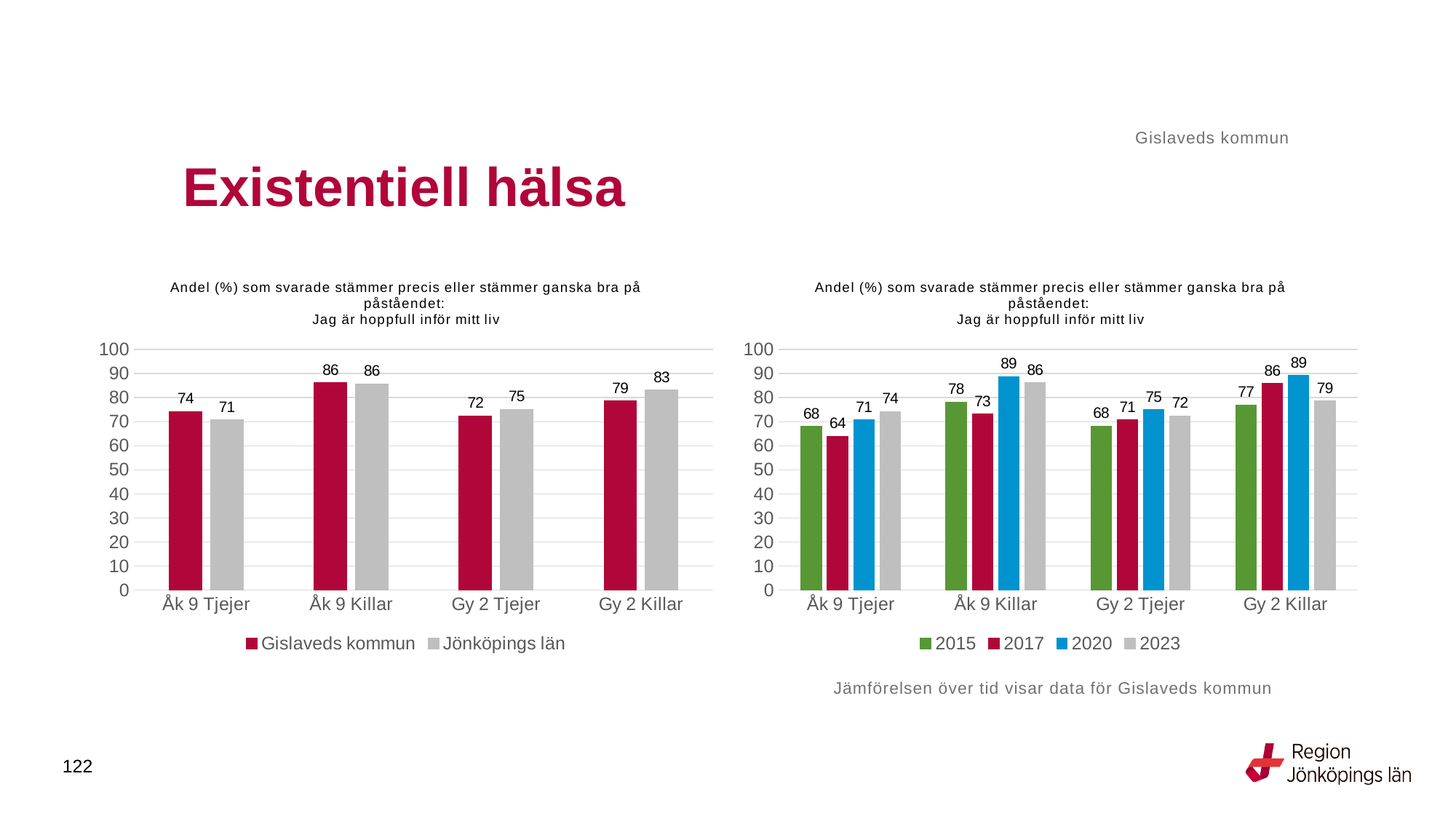
In the left chart, what is the difference between Jönköpings län and Gislaveds kommun for Gy 2 Killar? 4 In the left chart, what is the value for Jönköpings län for Gy 2 Killar? 83 In the right chart, how many series does the legend list? 4 In the left chart, which category has the lowest value for Jönköpings län? Åk 9 Tjejer In the right chart, which is larger for Gy 2 Tjejer: 2015 or 2020? 2020 What type of chart is the left chart? Bar chart In the right chart, which year has the highest value for Gy 2 Killar? 2020 In the right chart, what is the difference between the 2020 and 2017 values for Åk 9 Killar? 16 In the right chart, what is the value for 2017 for Åk 9 Tjejer? 64 In the right chart, what is the value for 2020 for Åk 9 Killar? 89 In the left chart, how many series does the legend list? 2 In the left chart, what is the value for Gislaveds kommun for Åk 9 Killar? 86